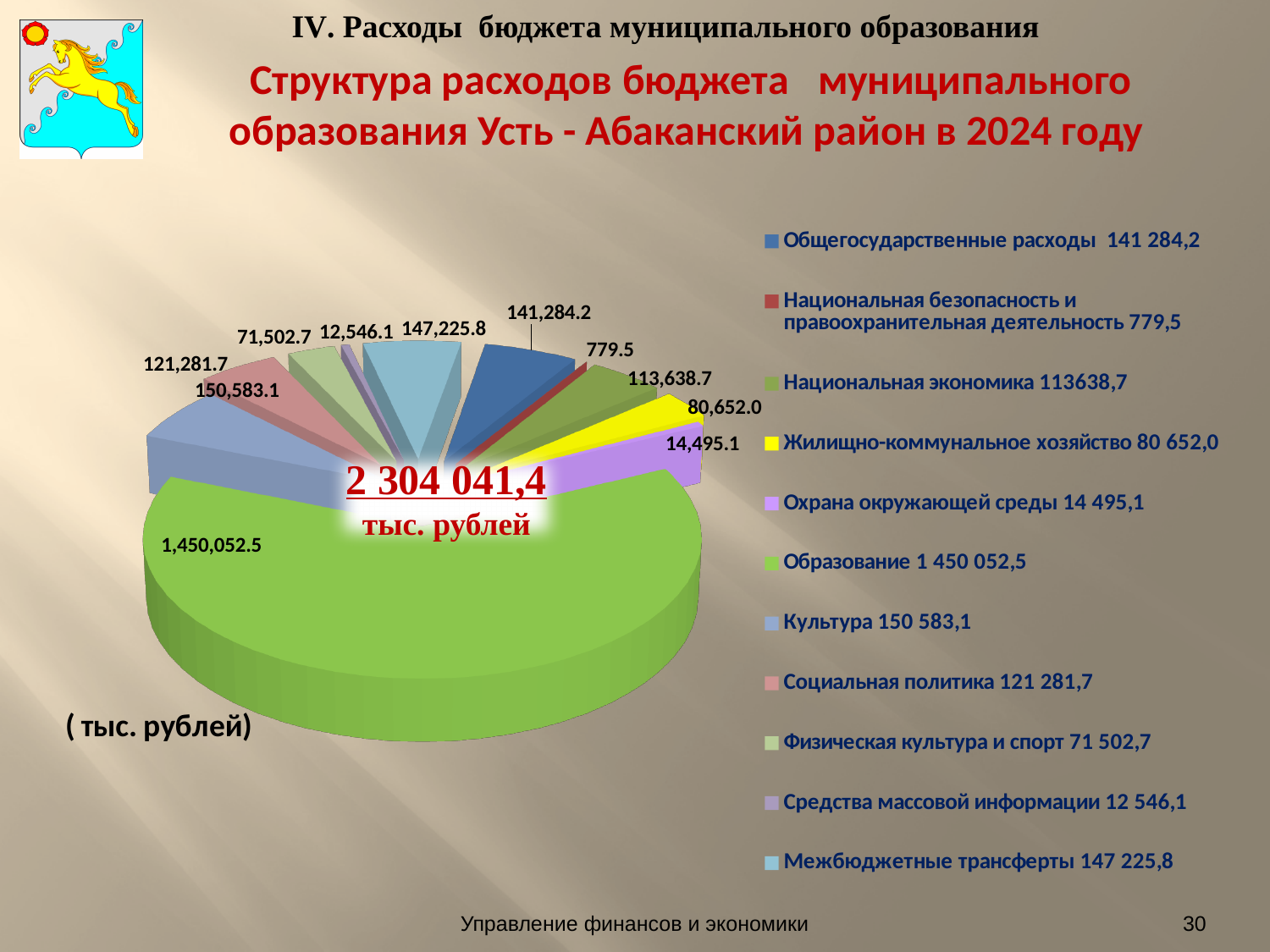
What is the value shown for Жилищно-коммунальное хозяйство in the pie chart? 80,652.0 How many expenditure categories does the legend of the pie chart list? 11 Which expenditure category has the largest slice of the pie chart? Образование Which is larger: the value for Культура or the value for Межбюджетные трансферты? Культура What is the value shown for Межбюджетные трансферты in the pie chart? 147,225.8 What kind of chart is shown on the slide? pie chart What is the value shown for Средства массовой информации in the pie chart? 12,546.1 What total amount is printed in the centre of the pie chart? 2 304 041,4 тыс. рублей In what units are the values of the pie chart expressed, according to the label on the slide? тыс. рублей What is the value shown for Образование (education) in the pie chart? 1,450,052.5 Which expenditure category has the smallest value in the pie chart? Национальная безопасность и правоохранительная деятельность What is the difference between the values for Общегосударственные расходы (141,284.2) and Социальная политика (121,281.7)? 20,002.5